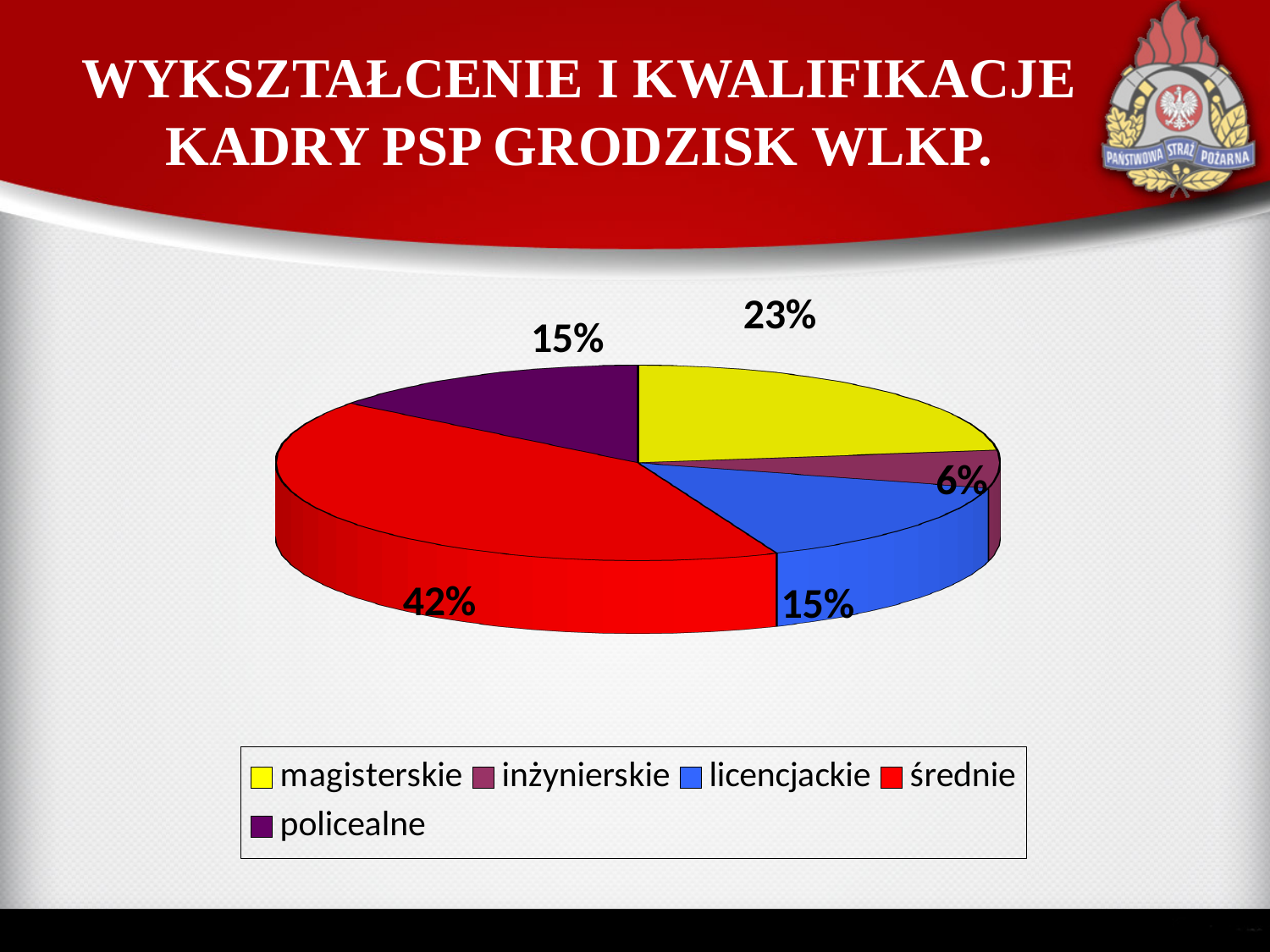
What colour is the "średnie" slice in the pie chart? red What share of the pie does the "licencjackie" slice represent? 15% What share of the pie does the "inżynierskie" slice represent? 6% What share of the pie does the "średnie" slice represent? 42% What kind of chart is shown on the slide? pie chart How many categories does the legend list? 5 Which category has the largest slice of the pie? średnie Which category has the smallest slice of the pie? inżynierskie What is the difference in percentage points between the "średnie" and "magisterskie" slices? 19 Which is larger, the "magisterskie" slice or the "licencjackie" slice? magisterskie